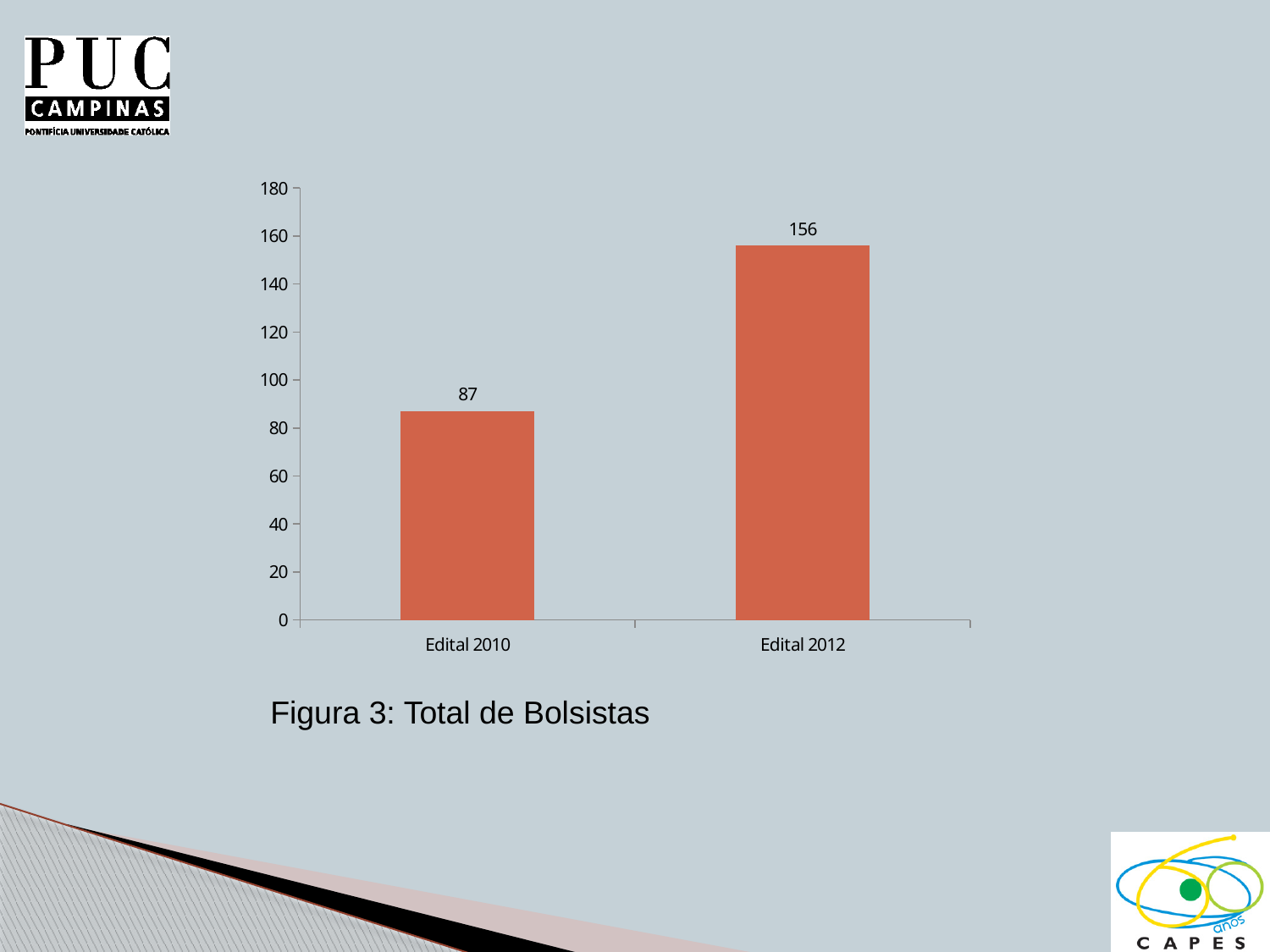
Do the values rise or fall from Edital 2010 to Edital 2012? rise Is the value for Edital 2010 greater or less than 100? less What is the value for Edital 2010? 87 What is the value for Edital 2012? 156 How many categories are shown on the x axis? 2 What is the caption given below the chart? Figura 3: Total de Bolsistas Which category has the highest value? Edital 2012 What kind of chart is shown on the slide? bar chart What is the difference between the values for Edital 2012 and Edital 2010? 69 Which is larger, the value for Edital 2010 or the value for Edital 2012? Edital 2012 Is the value for Edital 2012 greater or less than 140? greater Which category has the lowest value? Edital 2010